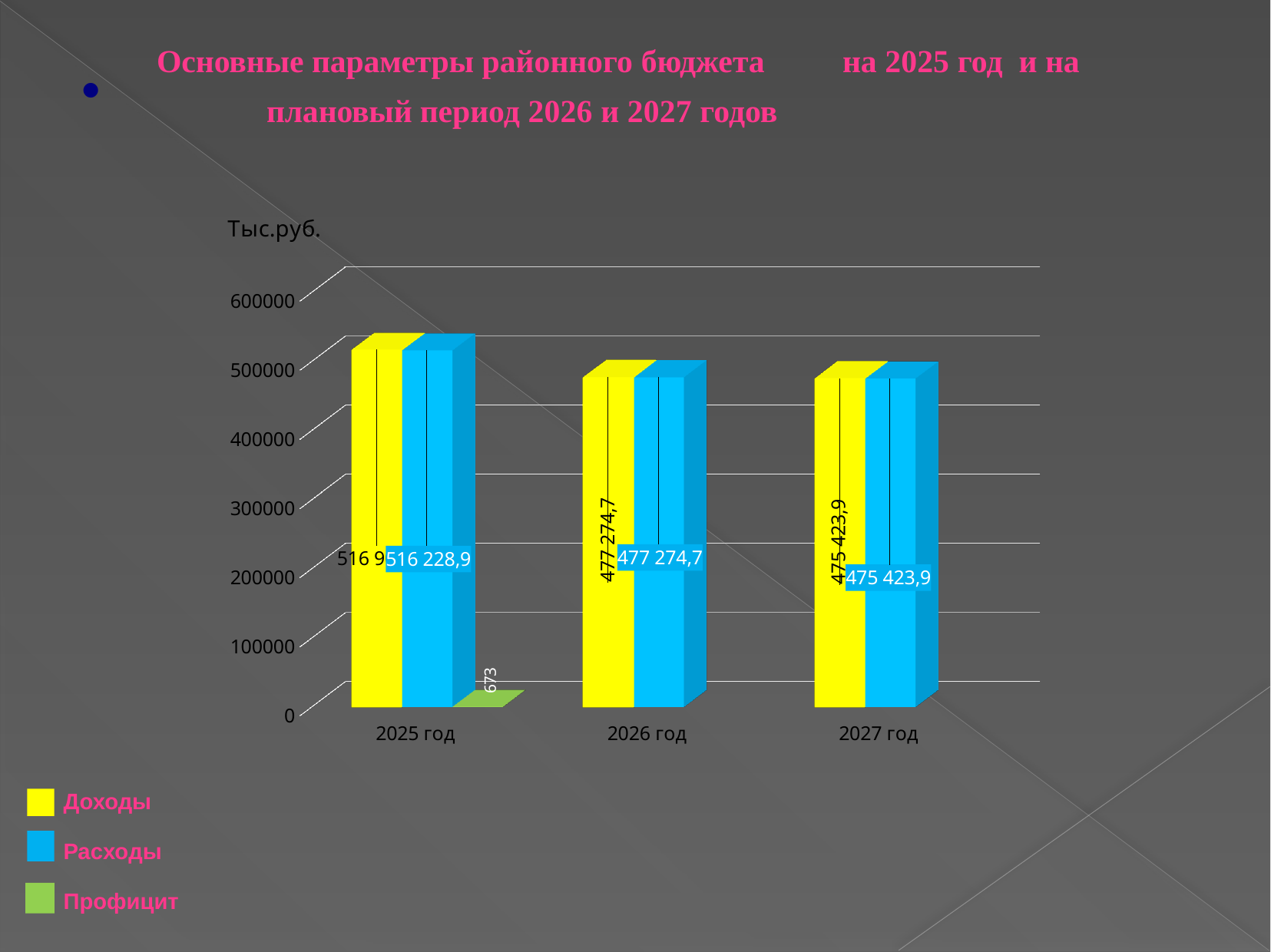
Which year has the highest Расходы value? 2025 год What unit label is shown above the vertical axis? Тыс.руб. What is the value of Расходы for 2027 год? 475 423,9 What is the difference between Расходы for 2025 год and Расходы for 2027 год? 40 805 What kind of chart is shown on the slide? bar chart What is the value of Доходы for 2026 год? 477 274,7 Is the value of Доходы for 2025 год greater or less than 500000? greater How many series does the legend list? 3 What is the value of Профицит for 2025 год? 673 Do the Расходы values rise or fall from 2025 год to 2027 год? fall What is the value of Расходы for 2025 год? 516 228,9 How many year categories are shown on the x axis? 3